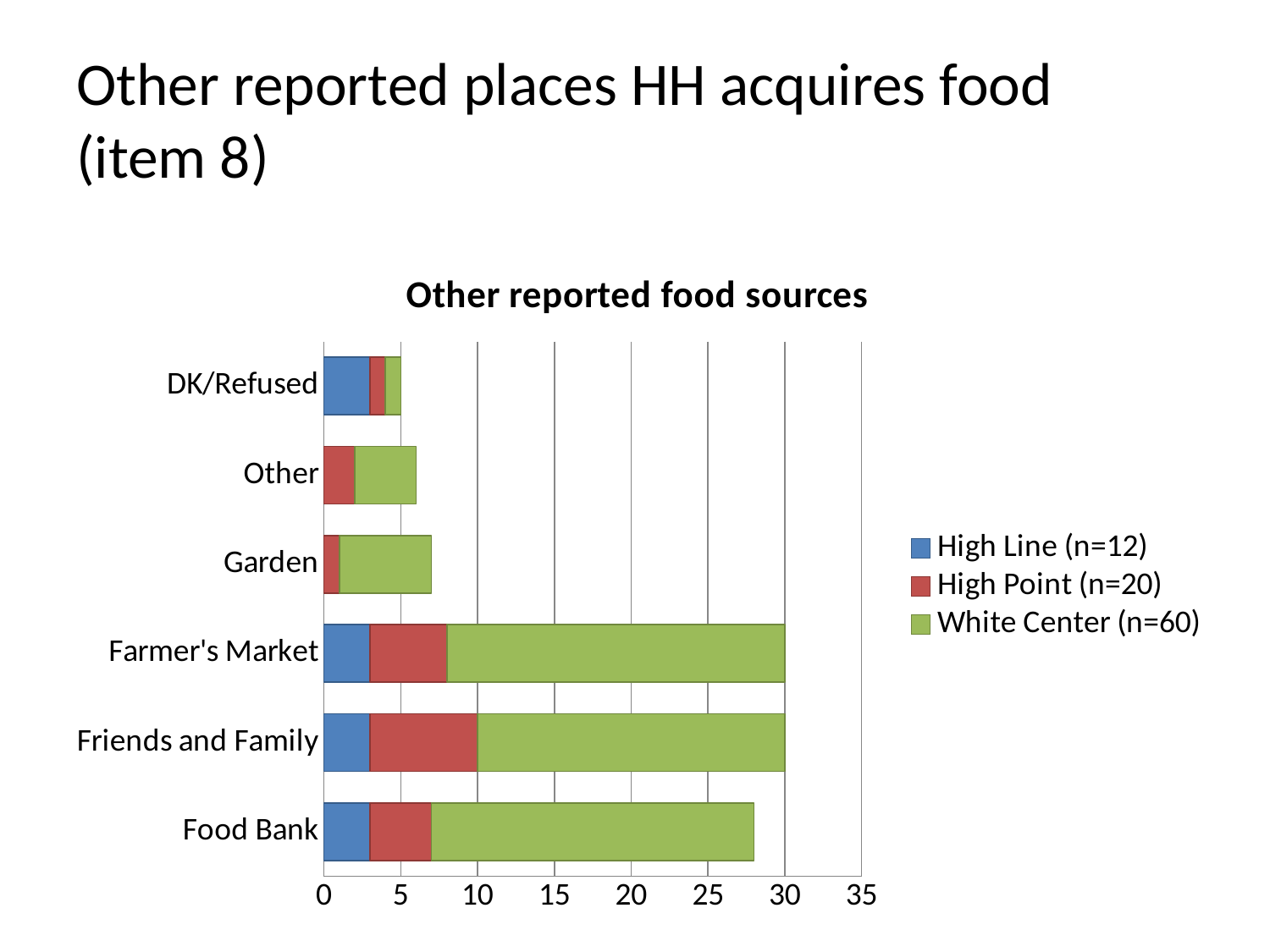
What is the total of the stacked bar for Friends and Family? 30 What is the total of the stacked bar for Farmer's Market? 30 Which has a larger total, Food Bank or Garden? Food Bank How many series does the legend list? 3 Which has a larger total, Farmer's Market or Other? Farmer's Market Is the total value for Garden greater or less than 10? less What kind of chart is shown on the slide? Stacked bar chart Which series in the legend has n=60? White Center (n=60) Is the total value for Food Bank greater or less than 25? greater What is the title of the chart? Other reported food sources How many categories are shown on the chart? 6 What is the total of the stacked bar for DK/Refused? 5